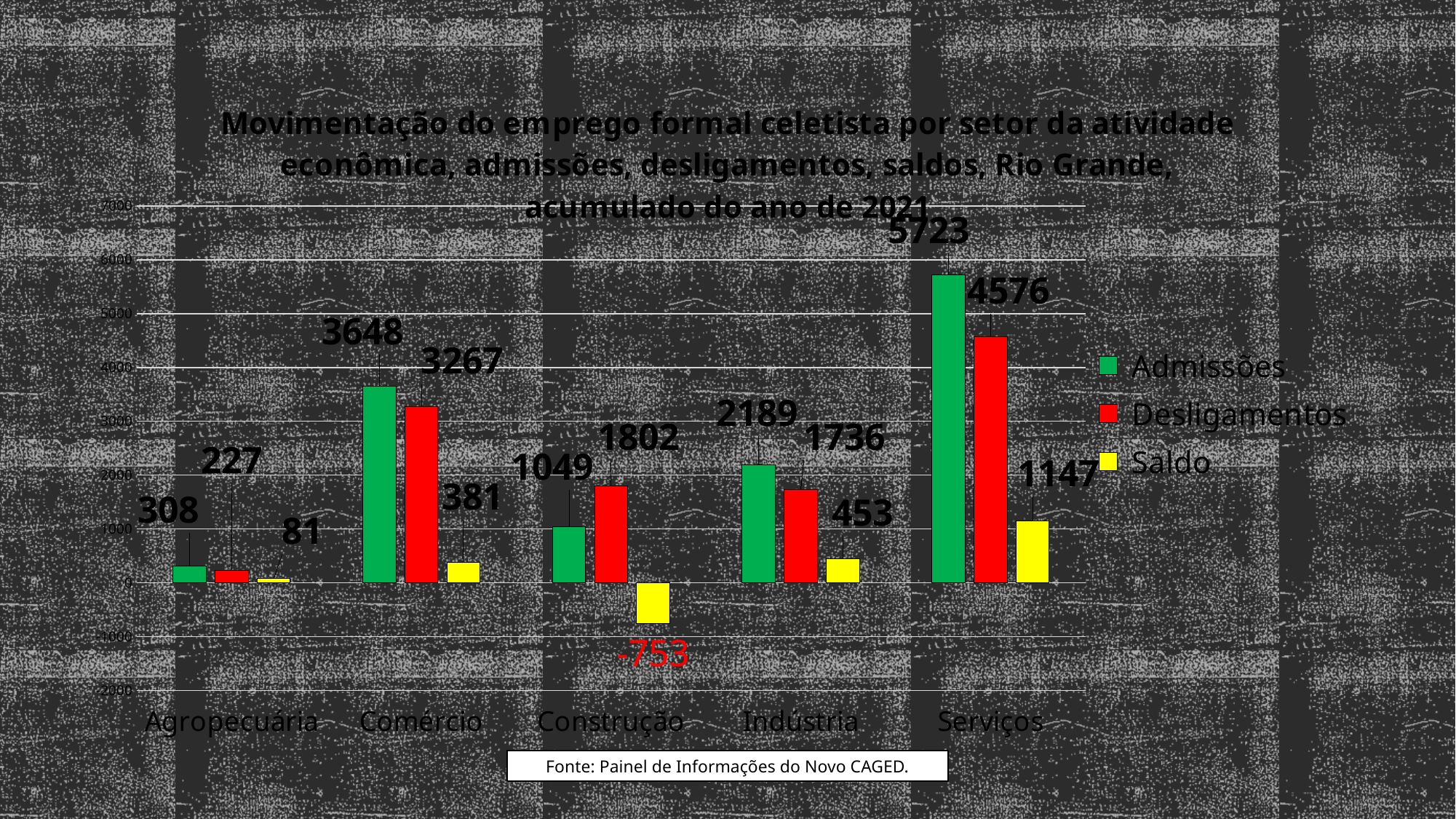
Is the Admissões value for Serviços greater or less than 5000? greater What kind of chart is shown on the slide? bar chart What is the value of Admissões for Comércio? 3648 Which sector has the highest Admissões value? Serviços What is the Saldo value for Construção? -753 Which colour represents Saldo in the legend? yellow Which is larger for Construção: Admissões or Desligamentos? Desligamentos What is the value of Desligamentos for Serviços? 4576 What is the difference between Admissões and Desligamentos for Indústria? 453 How many series does the legend list? 3 Which sector has the lowest Saldo value? Construção How many sectors are shown on the x axis? 5